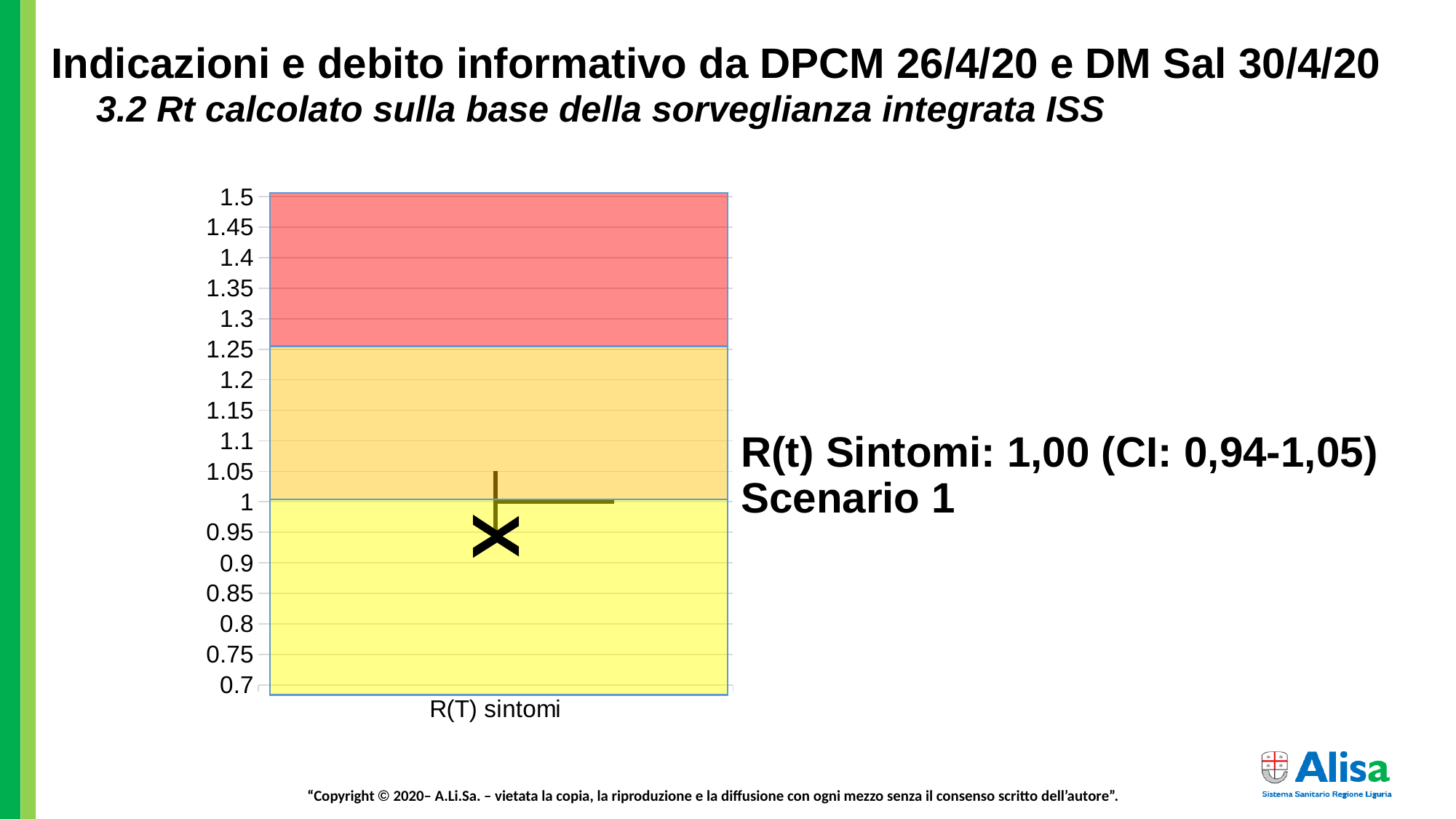
What is the label of the single category on the x axis of the chart? R(T) sintomi Is the top of the vertical range line plotted for R(T) sintomi greater or less than 1.1? less Is the top of the vertical range line plotted for R(T) sintomi greater or less than 1? greater At which y-axis value does the red band at the top of the chart begin? 1.25 What is the highest value shown on the y axis of the chart? 1.5 According to the text beside the chart, what is the confidence interval (CI) for R(t) Sintomi? 0,94-1,05 What is the lowest value shown on the y axis of the chart? 0.7 How many categories are shown on the x axis of the chart? 1 In which coloured band of the chart does the X marker for R(T) sintomi lie? yellow According to the text beside the chart, what is the value of R(t) Sintomi? 1,00 Which scenario is indicated next to the chart? Scenario 1